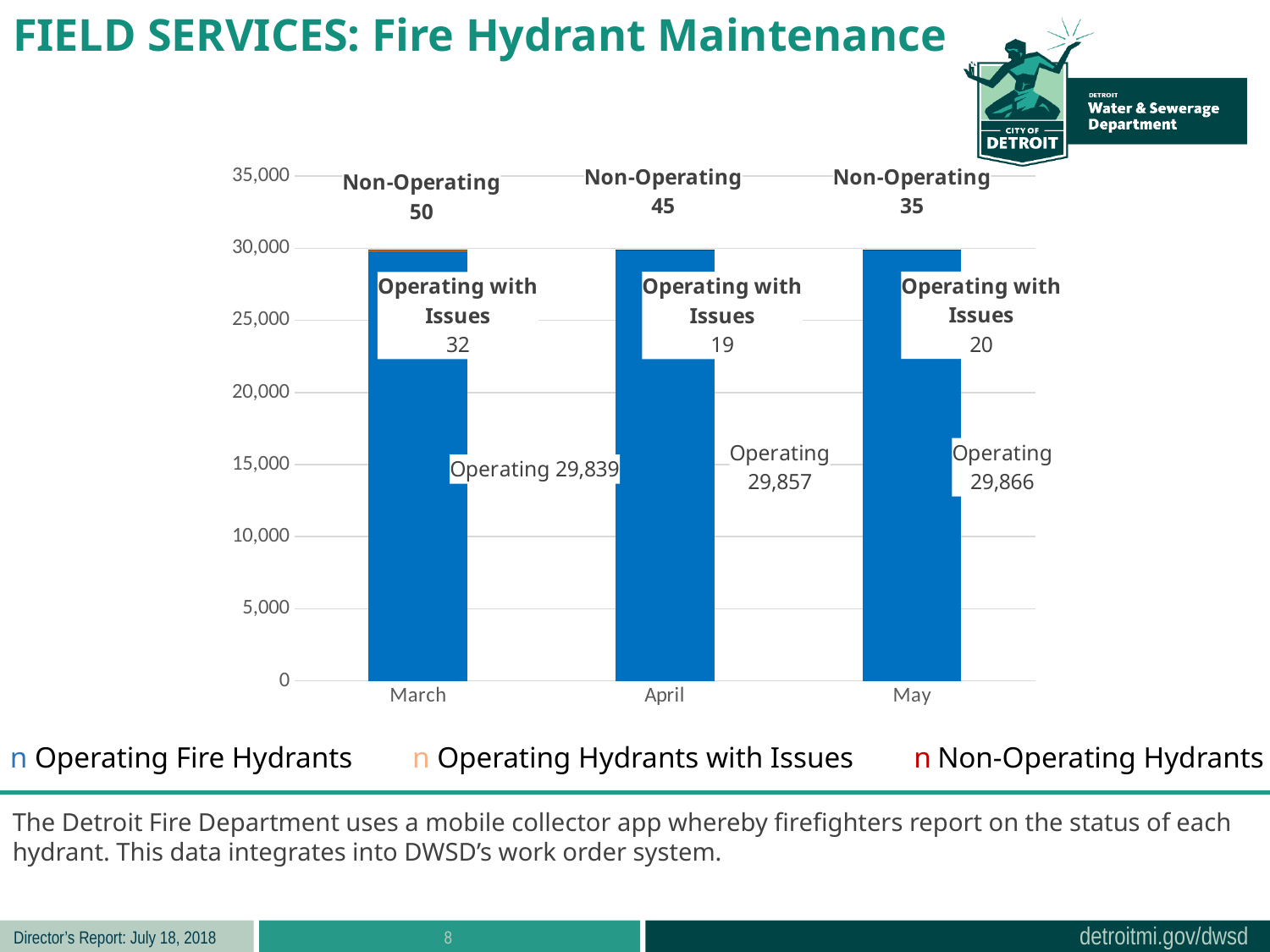
How many Non-Operating Hydrants are shown for April? 45 What is the difference between the Non-Operating Hydrants in March and in May? 15 What kind of chart is shown on the slide? Stacked bar chart In which month is the number of Non-Operating Hydrants highest? March In which month is the number of Operating Hydrants with Issues lowest? April What is the number of Operating Fire Hydrants in March? 29,839 How many series does the legend list? 3 Which is larger in April: Non-Operating Hydrants or Operating Hydrants with Issues? Non-Operating Hydrants Do the Operating Fire Hydrants values rise or fall from March to May? Rise How many months are shown on the x axis? 3 What is the value for Operating Hydrants with Issues in May? 20 By how much did the number of Operating Fire Hydrants increase from March to May? 27